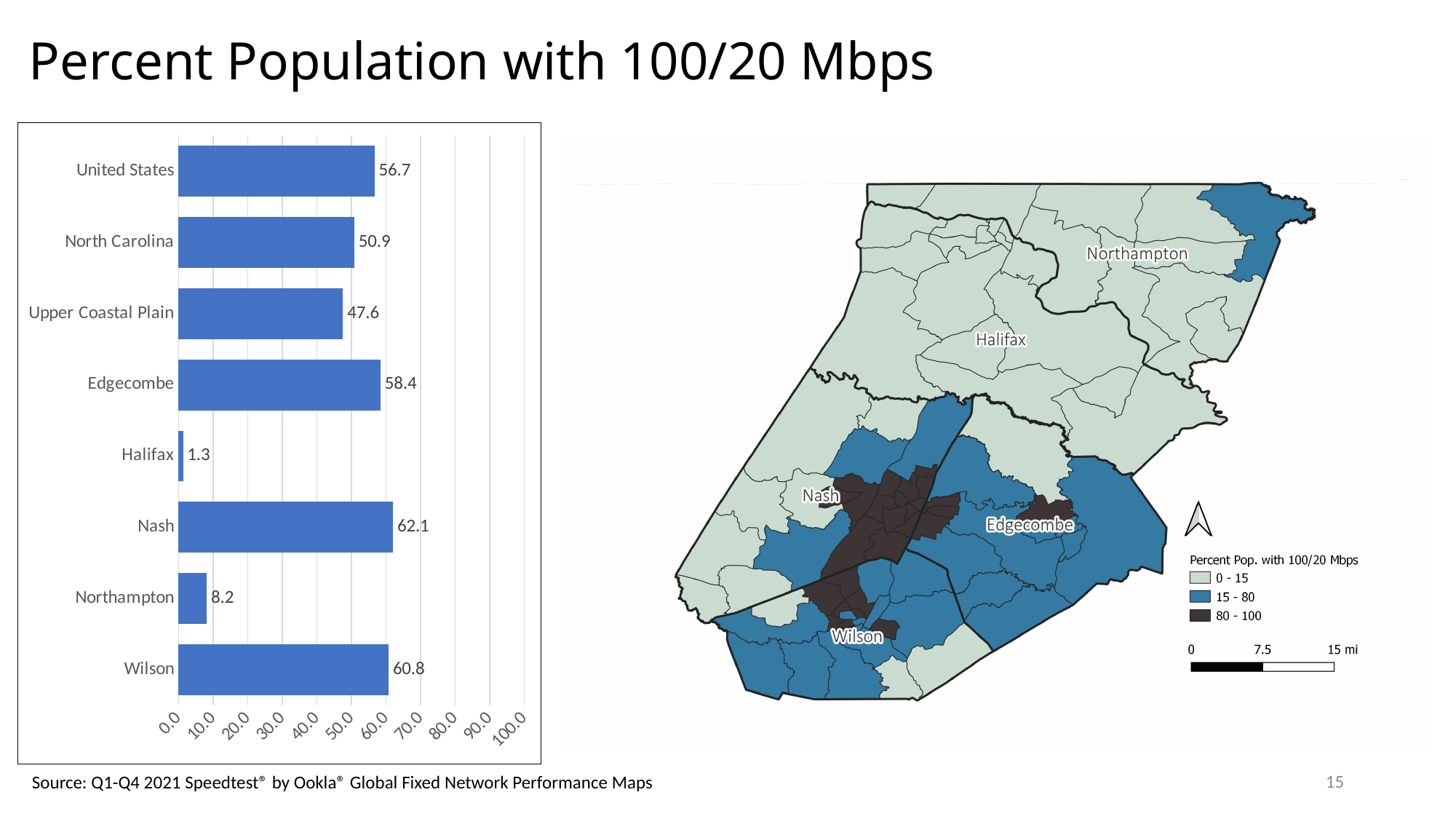
What type of chart is shown on the left of the slide? bar chart What is the value for Upper Coastal Plain in the bar chart? 47.6 Which category has the lowest value in the bar chart? Halifax What is the difference between the values for United States and North Carolina in the bar chart? 5.8 What is the value for North Carolina in the bar chart? 50.9 Which has a larger value in the bar chart, Edgecombe or United States? Edgecombe Which category has the highest value in the bar chart? Nash What is the value for Halifax in the bar chart? 1.3 What is the difference between the values for Nash and Wilson in the bar chart? 1.3 What is the value for Nash in the bar chart? 62.1 How many categories are shown in the bar chart? 8 Is the value for Northampton in the bar chart greater or less than 10.0? less